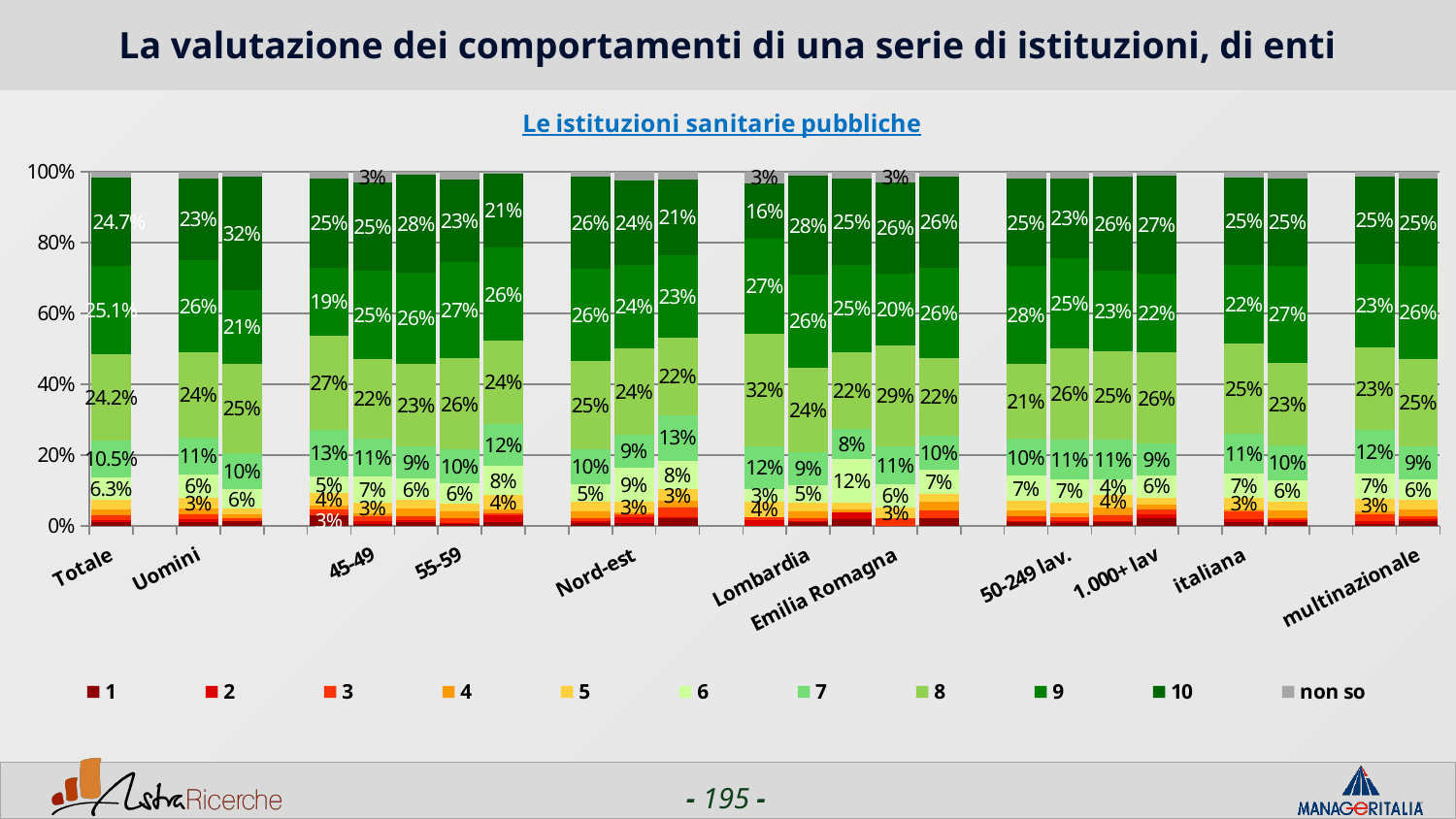
In the Totale bar, which is larger: the value for series 9 or the value for series 10? 9 What is the value for series 10 in the Uomini bar? 23% What is the value for series 7 in the Totale bar? 10.5% In the Uomini bar, what is the difference between the value for series 9 and the value for series 10? 3% What is the value for series 9 in the Uomini bar? 26% What kind of chart is shown on the slide? stacked bar chart What is the value for series 10 in the Totale bar? 24.7% What is the value for series 8 in the Totale bar? 24.2% What is the value for series 6 in the Totale bar? 6.3% How many series does the legend list? 11 What is the subtitle shown above the chart? Le istituzioni sanitarie pubbliche What is the value for series 9 in the Totale bar? 25.1%